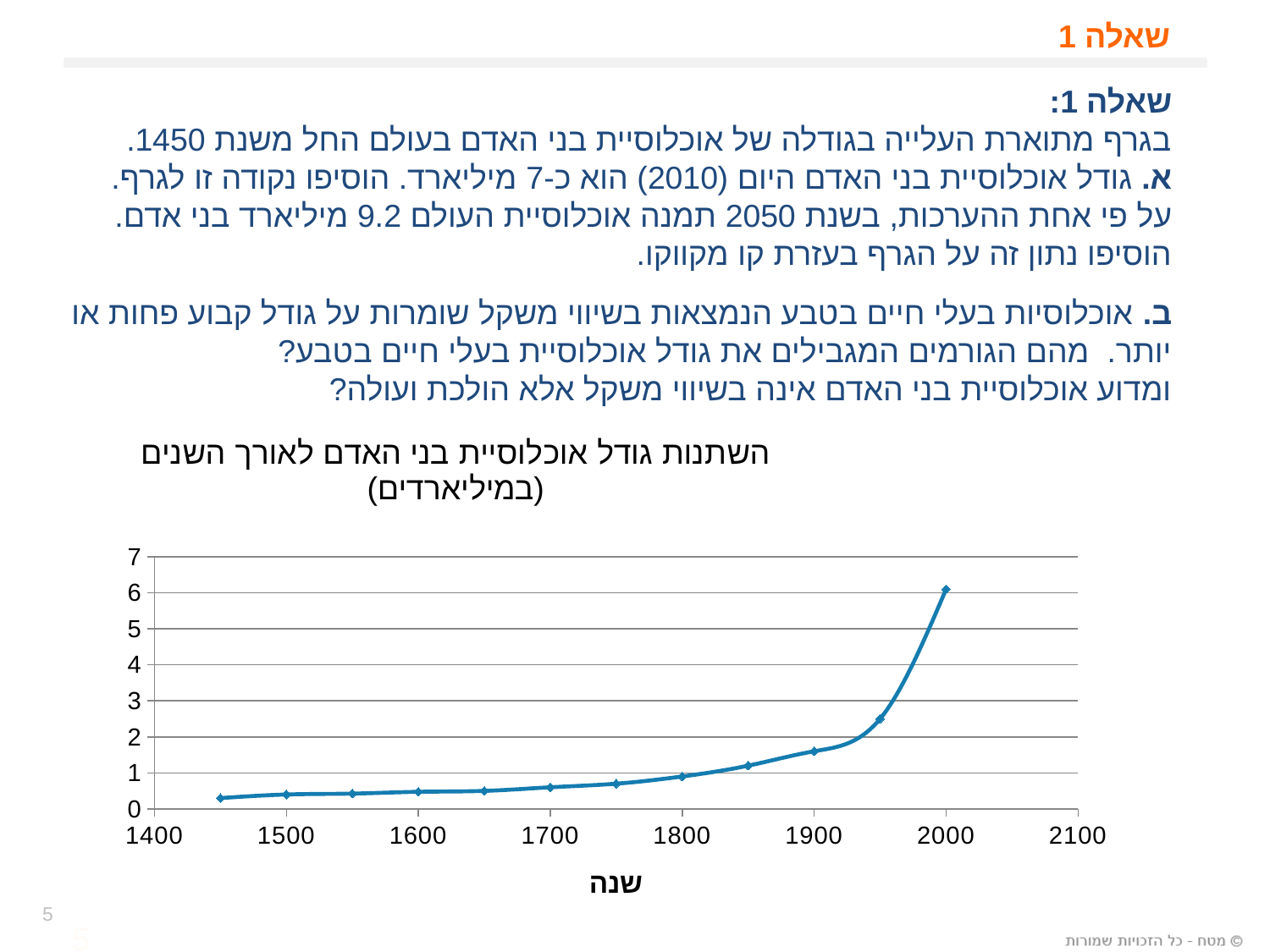
Which year has the larger plotted value, 1900 or 1950? 1950 What is the title of the x axis? שנה Which year has the lowest plotted value? 1450 Is the value for the year 2000 greater or less than 5? greater How many data points are plotted on the line? 12 Is the value for the year 1950 greater or less than 2? greater What kind of chart is shown on the slide? line chart Is the value for the year 1900 greater or less than 2? less Do the plotted values rise or fall as the year increases along the x axis? rise What is the highest tick value shown on the y axis? 7 Which year has the highest plotted value? 2000